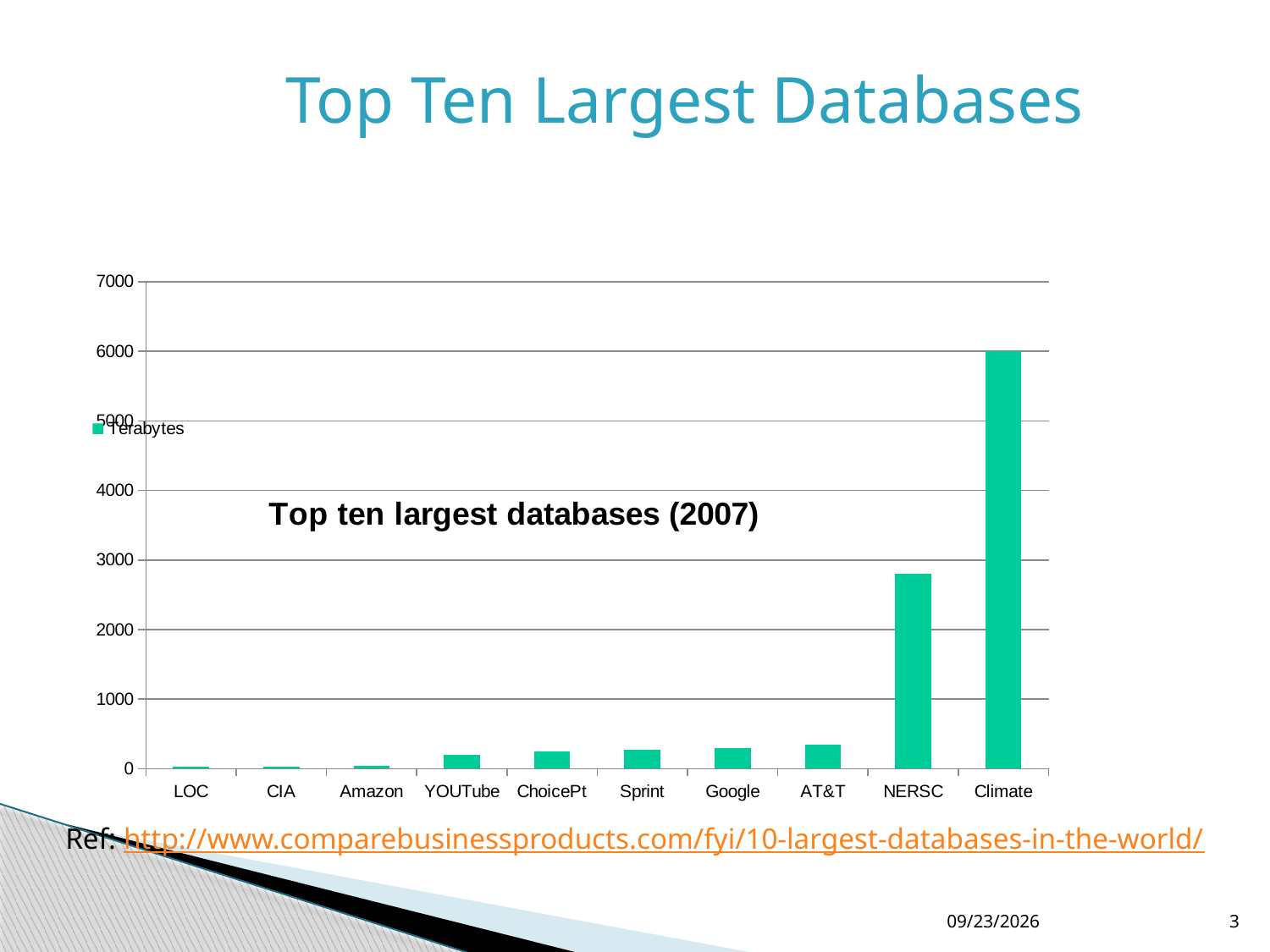
Which database has the highest value in the chart? Climate Is the value for Google greater or less than 1000? less Which is larger, the value for Climate or the value for NERSC? Climate Is the value for NERSC greater or less than 3000? less How many series does the legend list? 1 Is the value for NERSC greater or less than 2000? greater What is the legend entry for the plotted series? Terabytes Do the values generally rise or fall moving from left to right along the x axis? rise Which is larger, the value for NERSC or the value for Google? NERSC How many databases (categories) are plotted on the x axis? 10 What kind of chart is shown on the slide? bar chart What is the value for Climate in terabytes? 6000